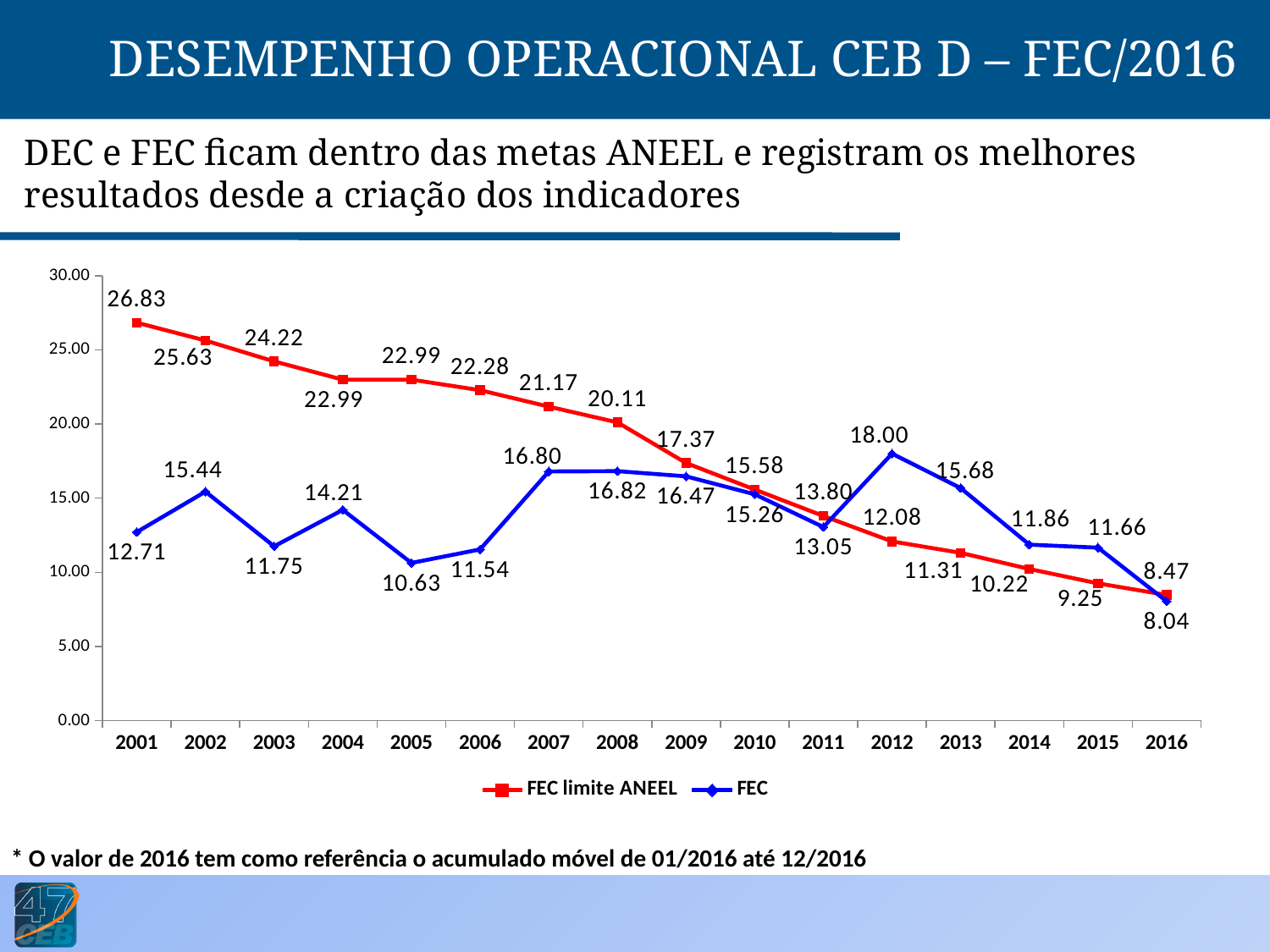
How many years are shown on the x axis? 16 What kind of chart is shown on the slide? Line chart What is the FEC value for 2016? 8.04 What is the FEC value for 2012? 18.00 Which is larger in 2012, the FEC value or the FEC limite ANEEL value? FEC Does the FEC limite ANEEL series rise or fall from 2001 to 2016? Fall In which year is the FEC limite ANEEL series at its lowest? 2016 In which year is the FEC series at its lowest? 2016 What is the difference between the FEC limite ANEEL value and the FEC value in 2001? 14.12 In which year is the FEC series at its highest? 2012 What is the FEC limite ANEEL value for 2001? 26.83 How many series does the legend list? 2